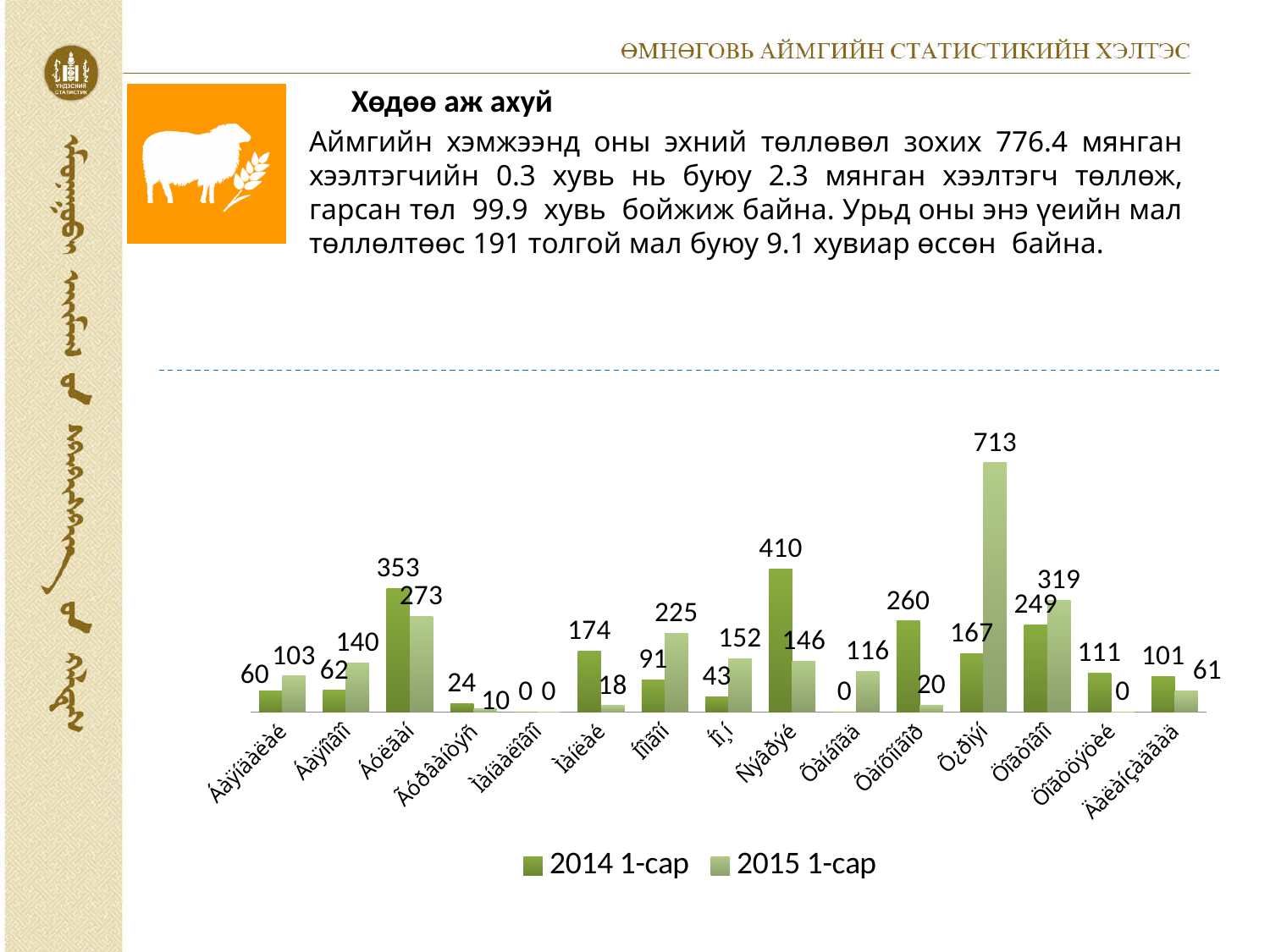
What are the two series named in the chart legend? 2014 1-сар and 2015 1-сар How many categories are plotted along the x axis of the chart? 15 What is the difference between the 2015 1-сар and 2014 1-сар values for the category with the tallest bar (713)? 546 What is the 2015 1-сар value for the last category on the right? 61 What is the highest value plotted for the 2014 1-сар series? 410 What is the difference between the 2014 1-сар and 2015 1-сар values for the third category from the left? 80 What kind of chart is shown on the slide? bar chart How many series does the chart legend list? 2 What is the highest value plotted for the 2015 1-сар series? 713 For the first category on the left, which series has the larger value, 2014 1-сар or 2015 1-сар? 2015 1-сар What is the 2015 1-сар value for the third category from the left? 273 What is the 2014 1-сар value for the third category from the left? 353